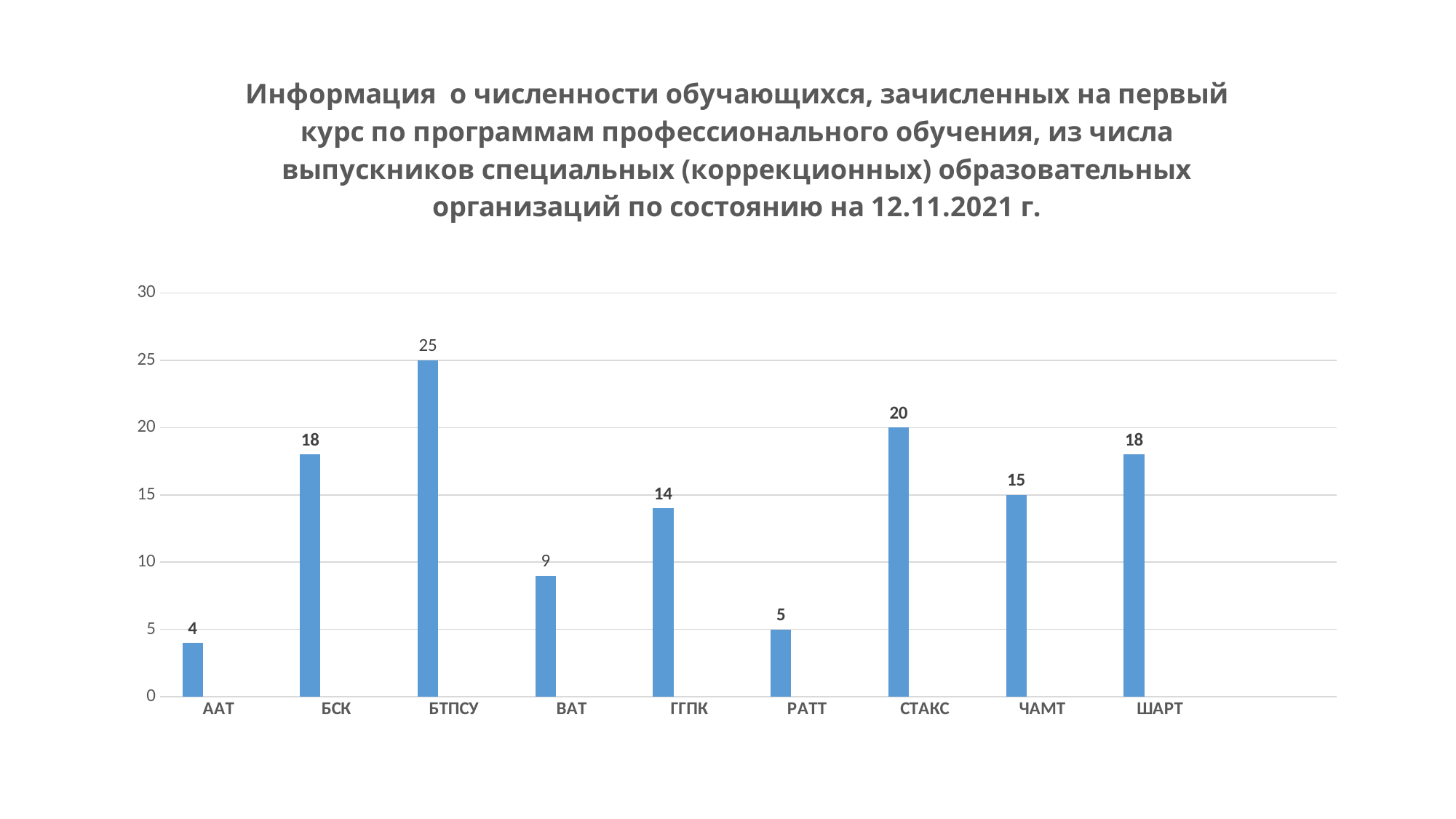
Which category has the highest value? БТПСУ What colour are the bars in the chart? blue What is the difference between the values for СТАКС and ВАТ? 11 What kind of chart is shown on the slide? bar chart Which category has the lowest value? ААТ What is the value for БТПСУ? 25 What is the value for РАТТ? 5 What is the difference between the values for БТПСУ and ААТ? 21 How many categories are shown on the x axis? 9 Which is larger, the value for ЧАМТ or the value for ГГПК? ЧАМТ Is the value for БСК greater or less than 15? greater What is the value for ГГПК? 14